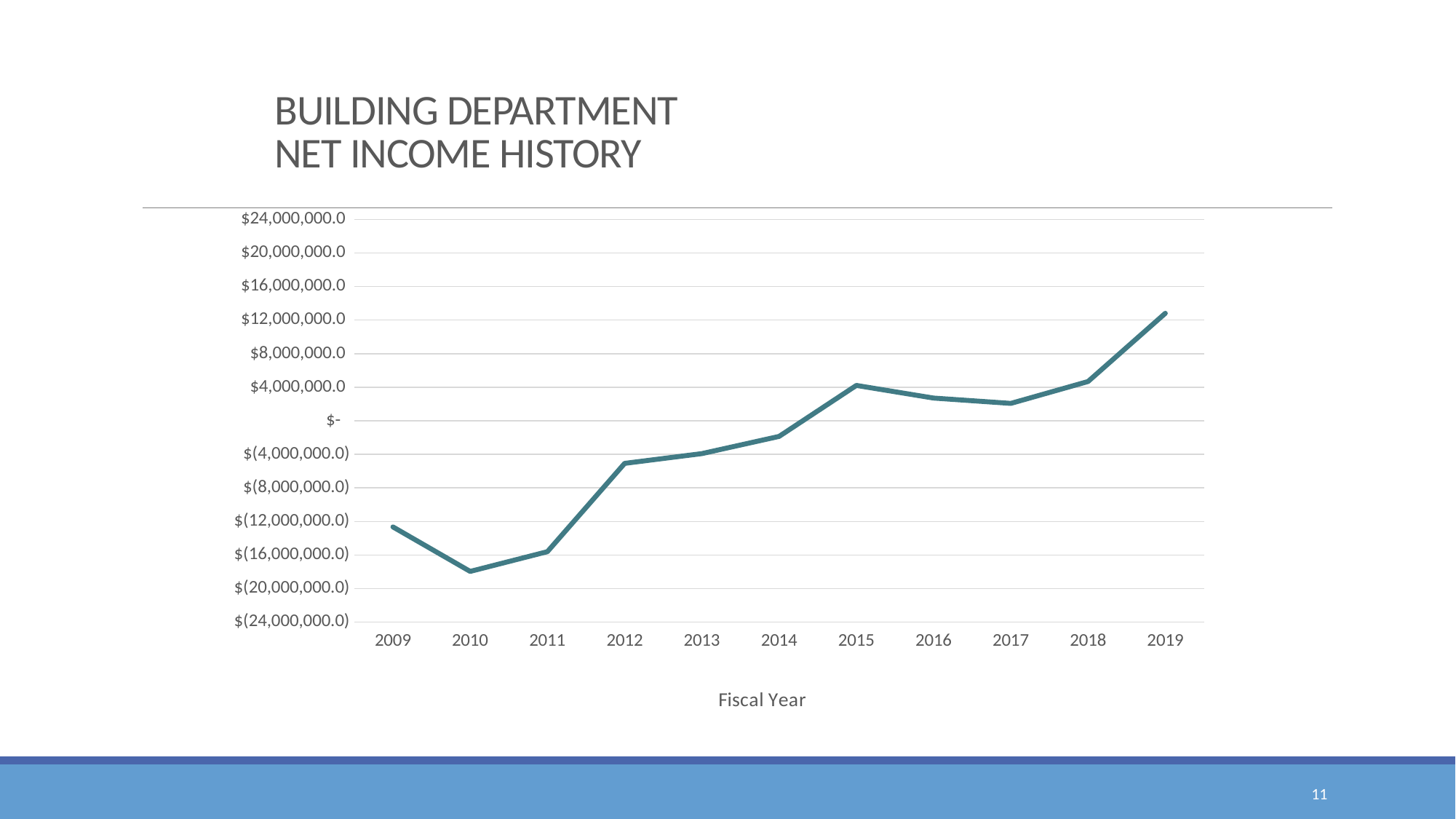
How many fiscal years are plotted on the x axis? 11 What kind of chart is shown on the slide? line chart Which fiscal year has the larger net income, 2010 or 2011? 2011 Overall, does net income rise or fall from 2009 to 2019? rise Which fiscal year has the lowest net income? 2010 Is the value for 2015 greater or less than $-? greater What is the label on the x axis of the chart? Fiscal Year Is the value for 2009 greater or less than $(8,000,000.0)? less Is the value for 2019 greater or less than $8,000,000.0? greater Which fiscal year has the larger net income, 2015 or 2017? 2015 Which fiscal year has the highest net income? 2019